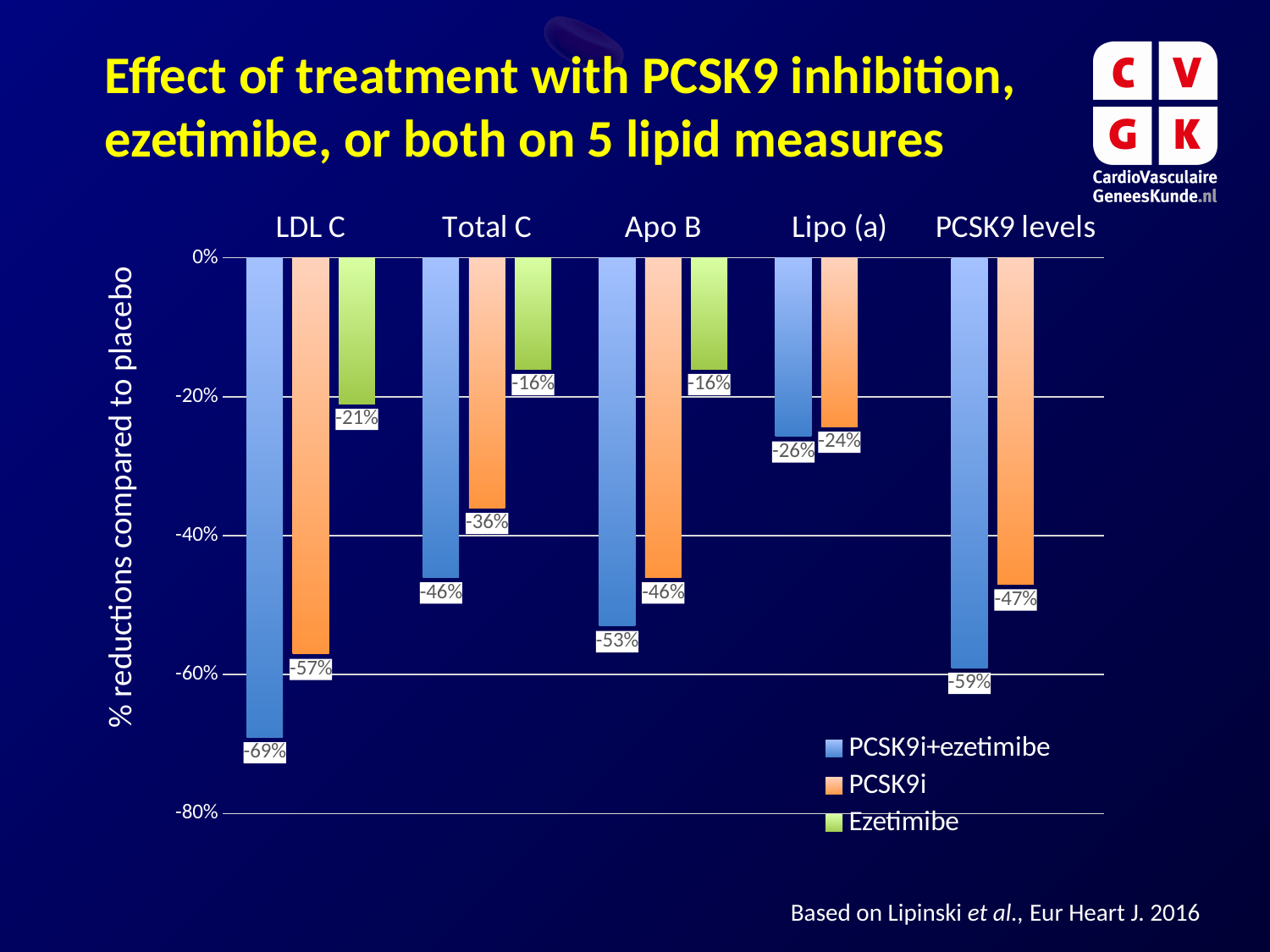
How many series does the legend list? 3 What is the value for Ezetimibe for Apo B? -16% How many lipid measures (categories) are shown on the x axis? 5 What kind of chart is shown on the slide? Bar chart What is the value for PCSK9i for Total C? -36% Which is the larger reduction for Apo B: PCSK9i+ezetimibe or PCSK9i? PCSK9i+ezetimibe Which series is shown in green in the legend? Ezetimibe Which lipid measure shows the largest reduction for PCSK9i+ezetimibe? LDL C What is the value for PCSK9i for PCSK9 levels? -47% What is the difference between the PCSK9i+ezetimibe and PCSK9i values for LDL C? 12 percentage points Which lipid measure shows the smallest reduction for PCSK9i? Lipo (a) What is the value for PCSK9i+ezetimibe for LDL C? -69%